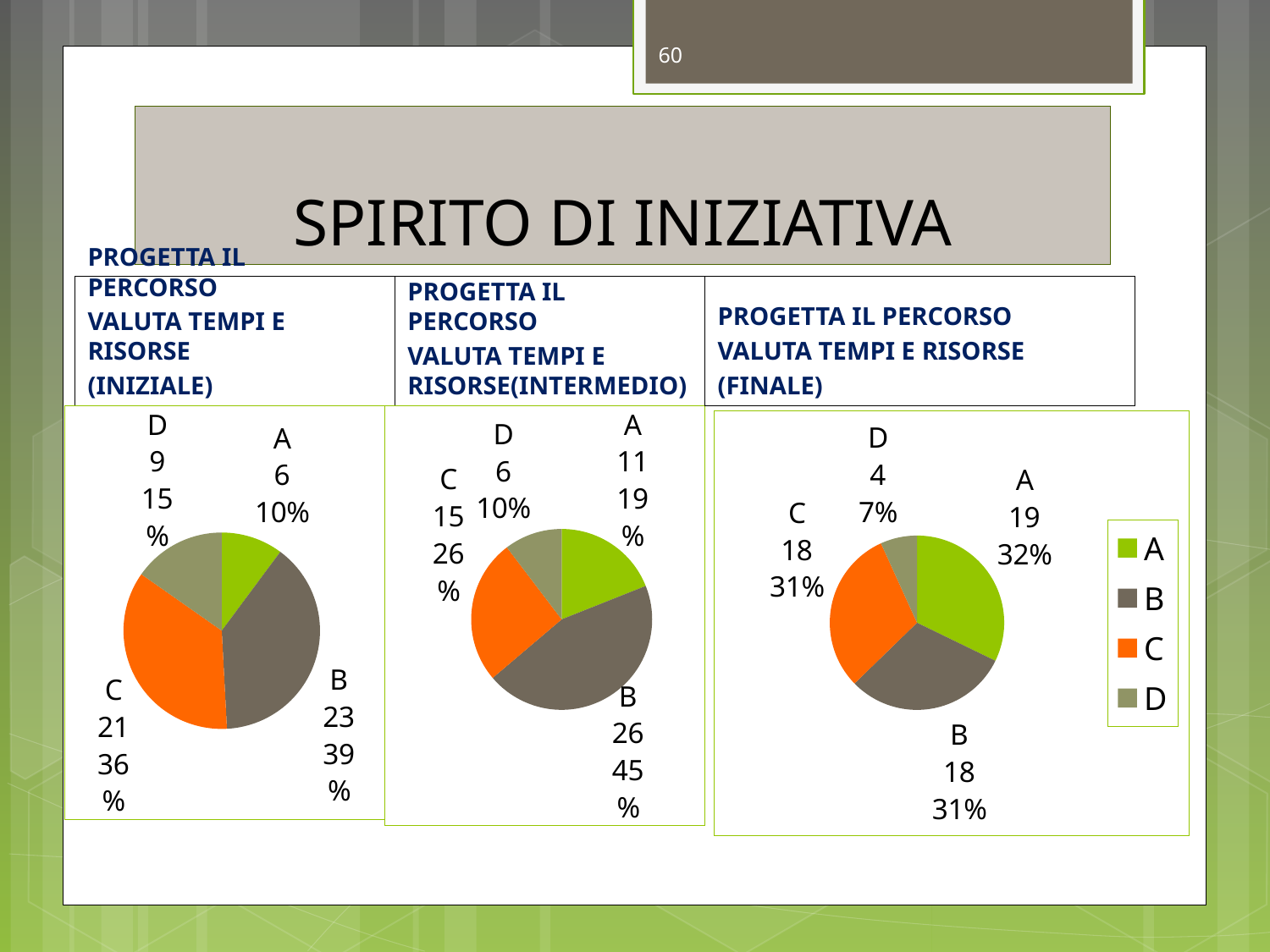
How many categories does the right pie chart (FINALE) show? 4 In the middle pie chart (INTERMEDIO), what is the difference between the values for B and C? 11 How many entries does the legend next to the right pie chart list? 4 In the middle pie chart (INTERMEDIO), what is the value for category A? 11 In the right pie chart (FINALE), what percentage share does category D have? 7% In the left pie chart (INIZIALE), which category has the smallest value? A In the right pie chart (FINALE), which is larger, the value for A or the value for D? A In the right pie chart (FINALE), what is the value for category A? 19 In the middle pie chart (INTERMEDIO), which category has the largest share? B What type of chart is used for the INIZIALE data on the left? Pie chart In the left pie chart (INIZIALE), what is the value for category B? 23 In the left pie chart (INIZIALE), what percentage share does category C have? 36%